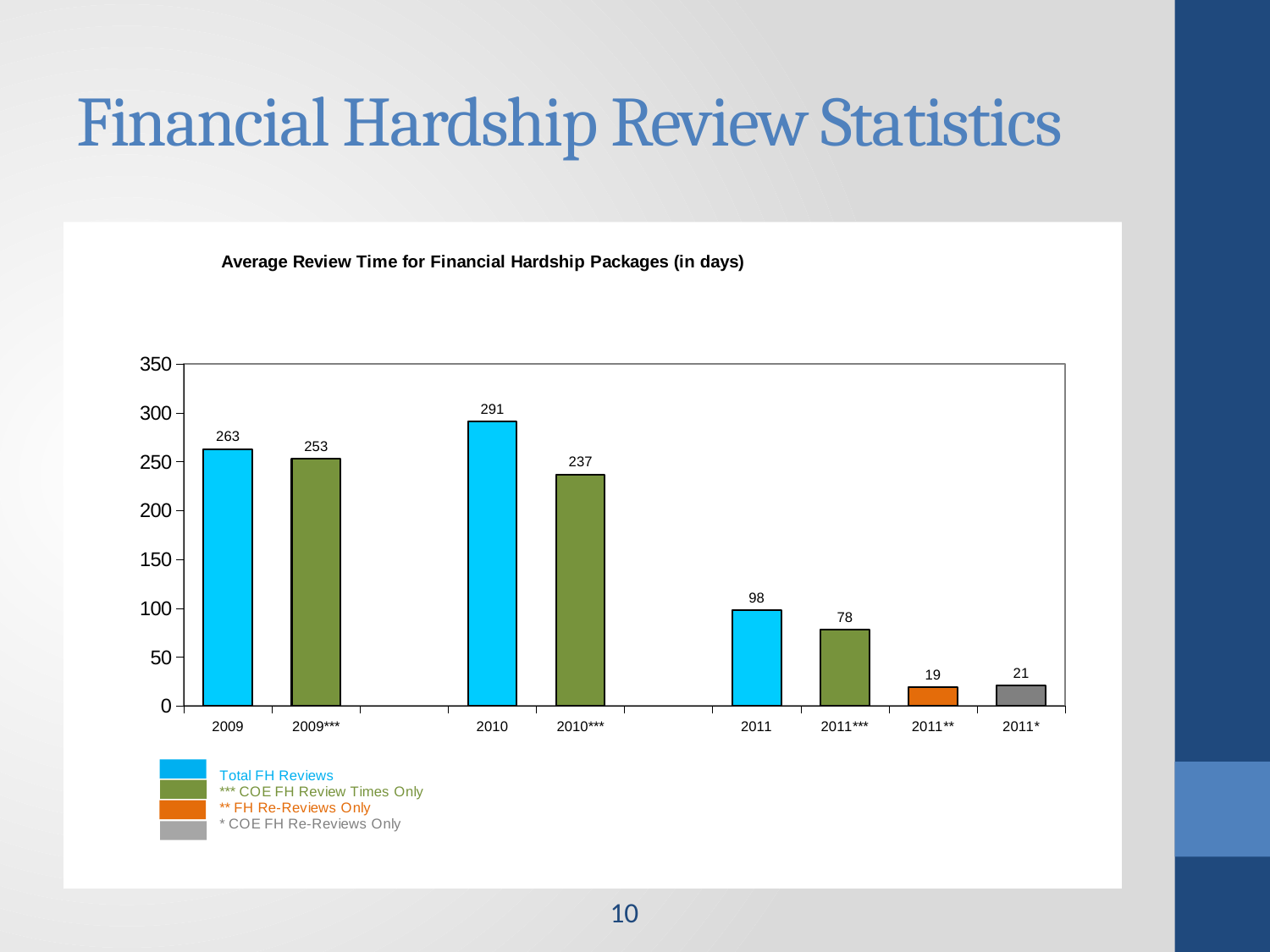
What is the difference between the values for 2009 and 2009***? 10 How many bars are plotted in the chart? 8 What is the value for 2010 in the chart? 291 How many entries does the legend list? 4 Which category has the lowest value? 2011** Which is larger, the value for 2011 or the value for 2011***? 2011 What kind of chart is shown on the slide? bar chart What is the value for 2011*** in the chart? 78 What is the title of the chart? Average Review Time for Financial Hardship Packages (in days) What is the difference between the values for 2010 and 2010***? 54 What is the value for 2011** in the chart? 19 Which category has the highest value? 2010